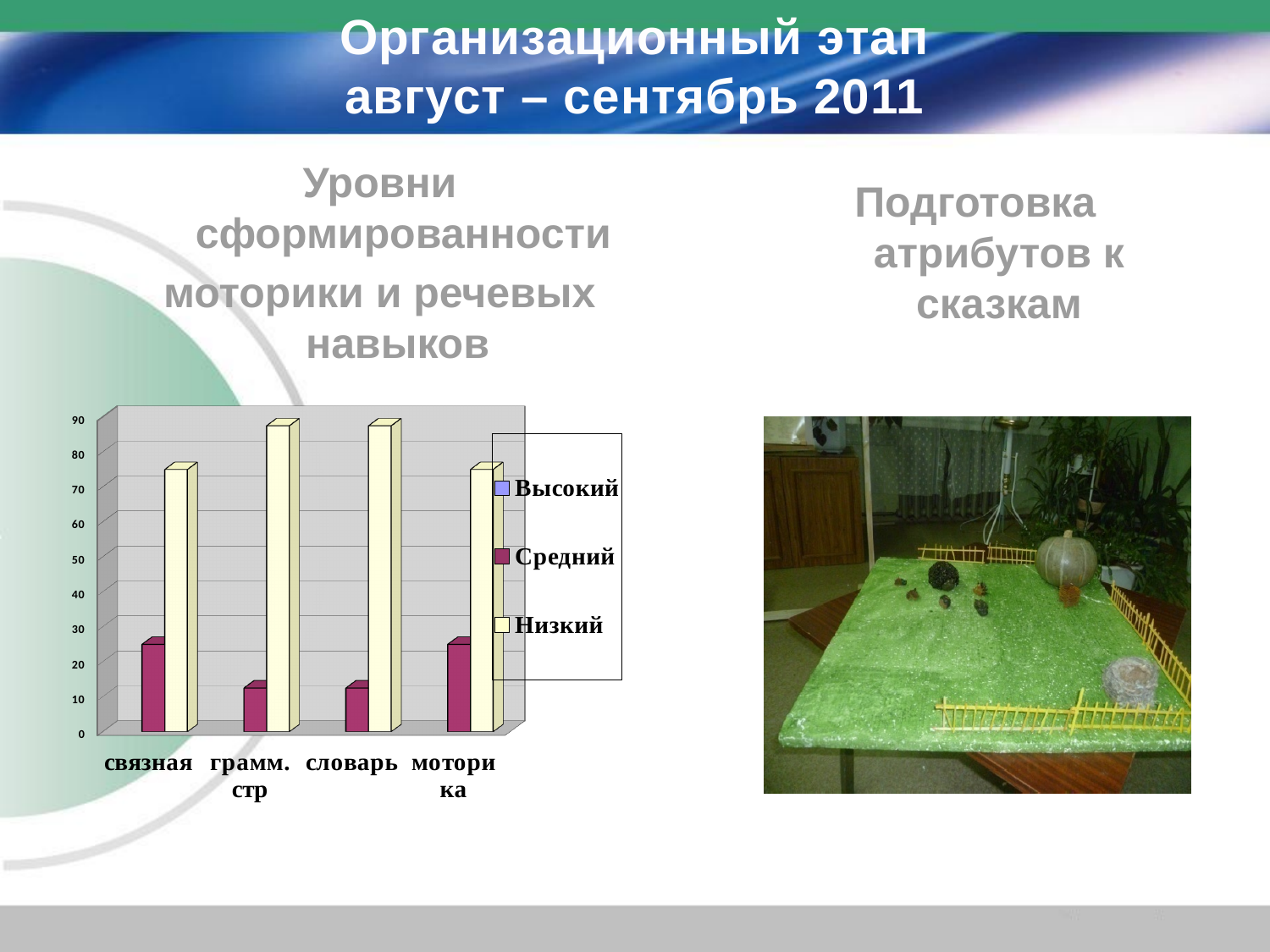
How many series does the chart legend list? 3 Is the value of Средний for связная greater or less than 20? greater What is the title of the chart? Уровни сформированности моторики и речевых навыков For Низкий, which is larger: the value for словарь or the value for связная? словарь For связная, which is larger: the Низкий value or the Средний value? Низкий Is the value of Средний for словарь greater or less than 20? less What are the three series listed in the chart legend? Высокий, Средний, Низкий How many categories are shown on the x axis of the chart? 4 For Средний, which is larger: the value for моторика or the value for грамм. стр? моторика Is the value of Низкий for связная greater or less than 80? less What kind of chart is shown on the slide? bar chart